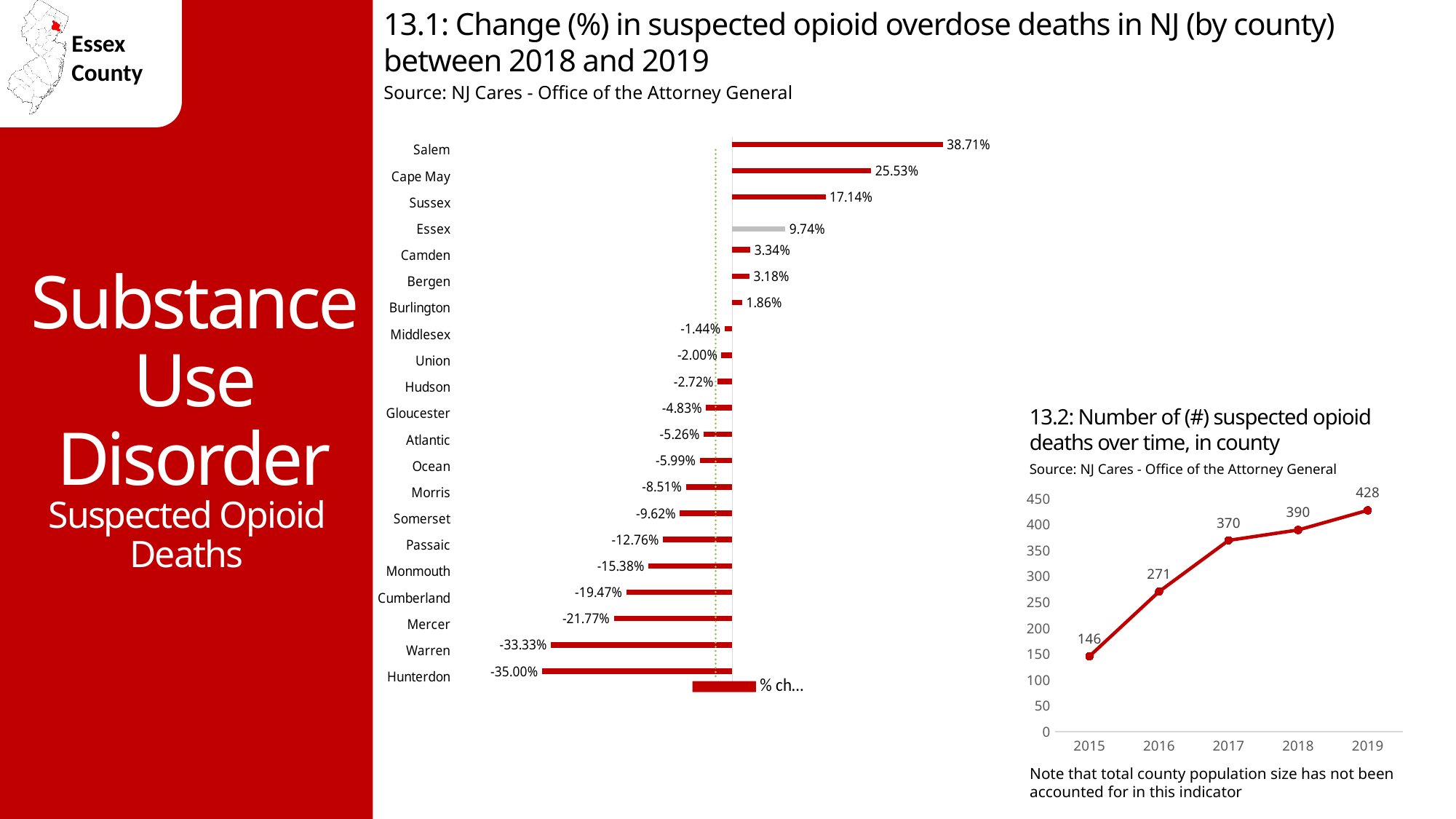
In chart 13.1, which county has the lowest percentage change? Hunterdon In chart 13.1, what is the value for Cape May? 25.53% In chart 13.1, which is larger, the value for Sussex or the value for Camden? Sussex In chart 13.1 (Change (%) in suspected opioid overdose deaths in NJ by county), what is the value for Essex? 9.74% In chart 13.2 (Number of suspected opioid deaths over time, in county), what is the value for 2017? 370 In chart 13.2, do the values rise or fall from 2015 to 2019? Rise In chart 13.2, what kind of chart is used? Line chart In chart 13.2, how many years are plotted? 5 In chart 13.1, which county has the highest percentage change? Salem In chart 13.1, how many counties are shown? 21 In chart 13.1, what kind of chart is used? Bar chart In chart 13.2, what is the difference between the 2019 value and the 2015 value? 282